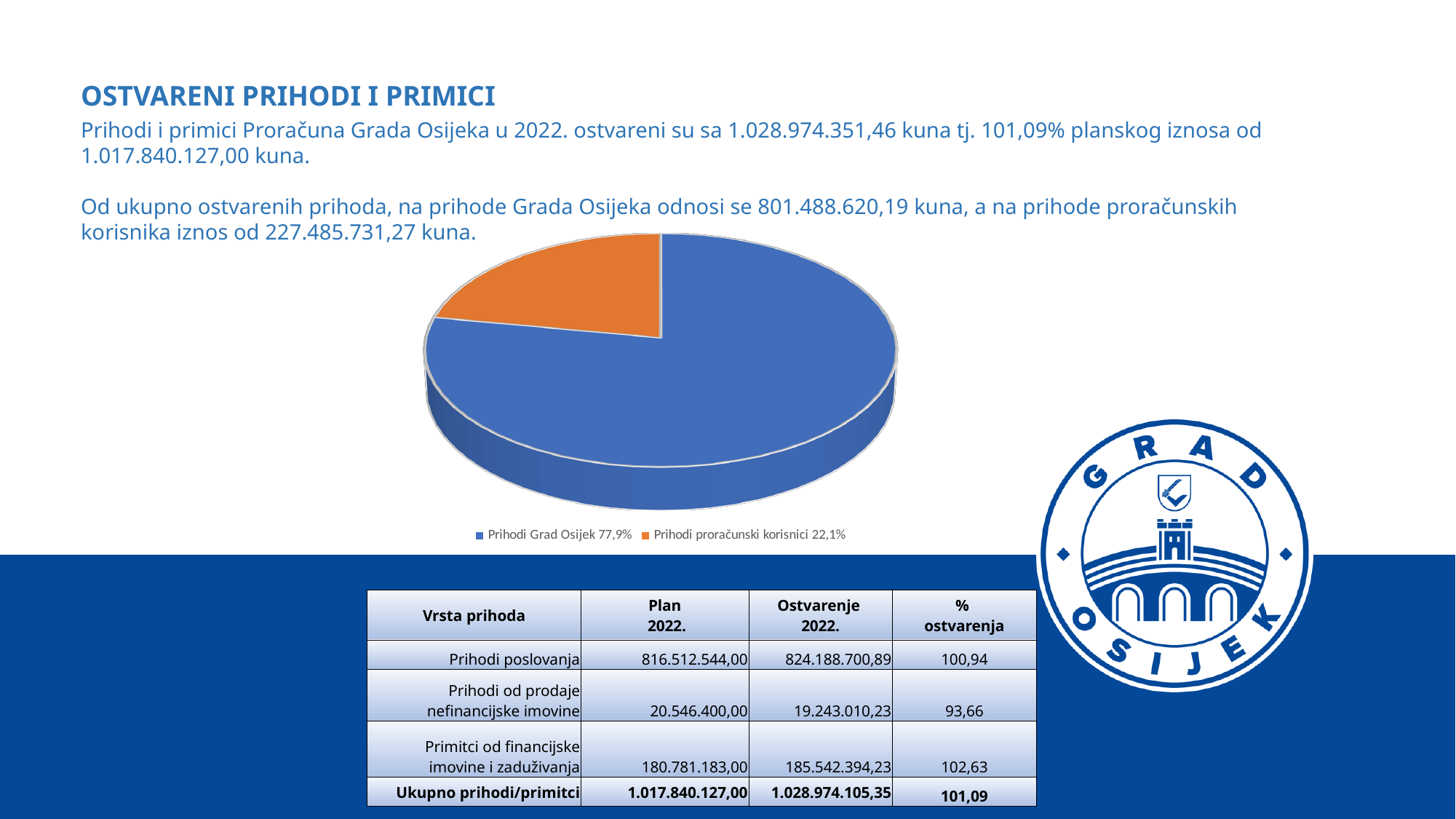
Which slice of the pie chart is the smallest? Prihodi proračunski korisnici How many entries does the pie chart's legend list? 2 What kind of chart is shown on the slide? pie chart Which slice of the pie chart is the largest? Prihodi Grad Osijek How many slices does the pie chart have? 2 What share of the pie does "Prihodi Grad Osijek" represent? 77,9% What colour is the Prihodi proračunski korisnici slice in the pie chart? orange What colour is the Prihodi Grad Osijek slice in the pie chart? blue Which is larger in the pie chart: Prihodi Grad Osijek or Prihodi proračunski korisnici? Prihodi Grad Osijek What share of the pie does "Prihodi proračunski korisnici" represent? 22,1% What is the difference in percentage points between the Prihodi Grad Osijek slice and the Prihodi proračunski korisnici slice? 55,8